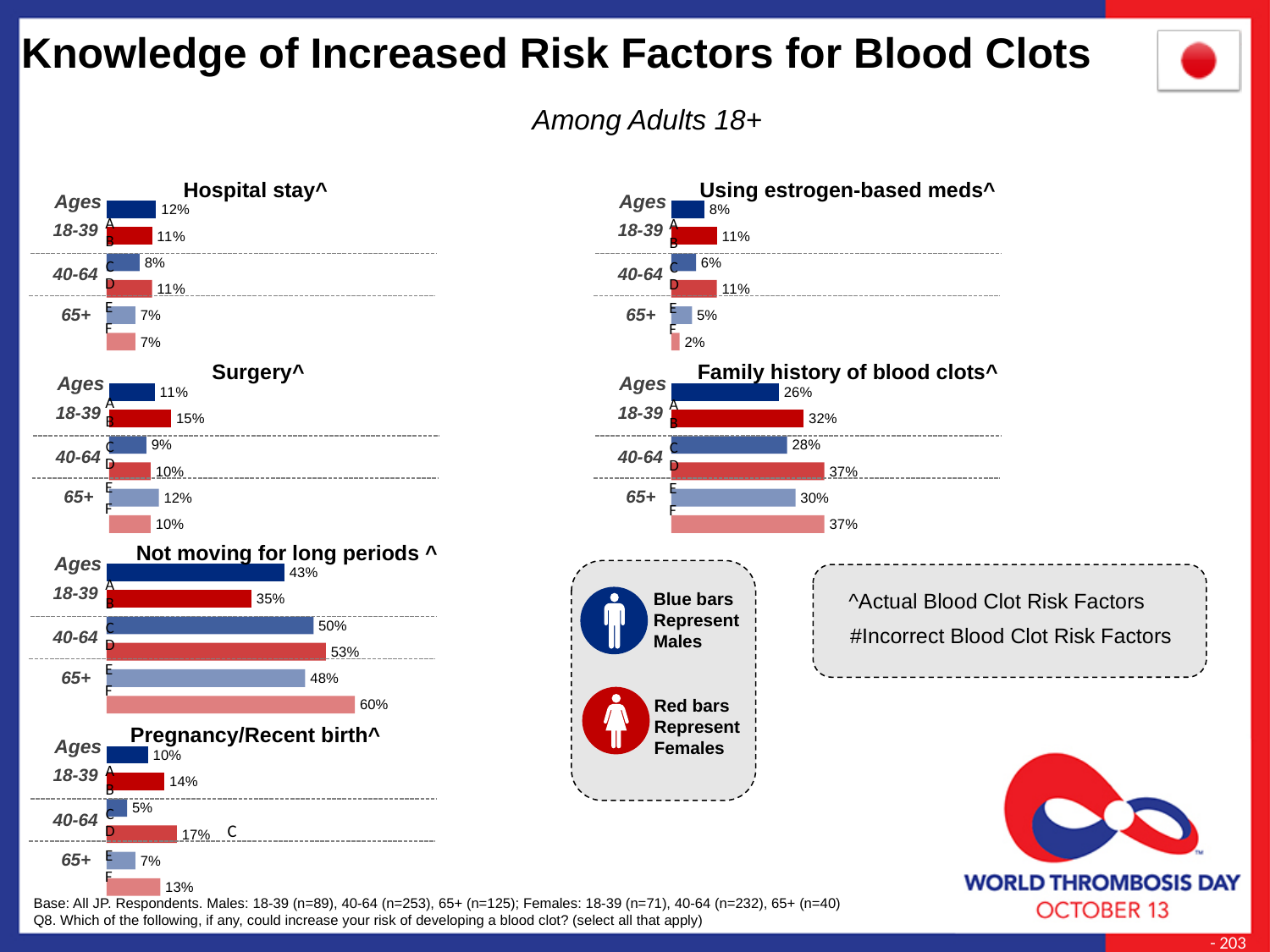
How many age groups are shown in each chart on the slide? 3 In the 'Not moving for long periods' chart, which group has the lowest value? Females 18-39 (35%) In the 'Family history of blood clots' chart, what is the value for males aged 18-39? 26% In the 'Surgery' chart, what is the difference between females aged 18-39 and males aged 18-39? 4 percentage points In the 'Using estrogen-based meds' chart, what is the value for females aged 65+? 2% In the 'Family history of blood clots' chart, what is the difference between females aged 40-64 and males aged 40-64? 9 percentage points In the 'Family history of blood clots' chart, do the male values rise or fall from ages 18-39 to 65+? Rise In the 'Not moving for long periods' chart, what percentage of females aged 65+ is shown? 60% In the 'Hospital stay' chart, which is larger: males aged 18-39 or males aged 40-64? Males aged 18-39 (12%) What type of chart is used for 'Hospital stay'? Bar chart In the 'Pregnancy/Recent birth' chart, which group has the highest value? Females 40-64 (17%) According to the legend on the slide, what do the red bars represent? Females